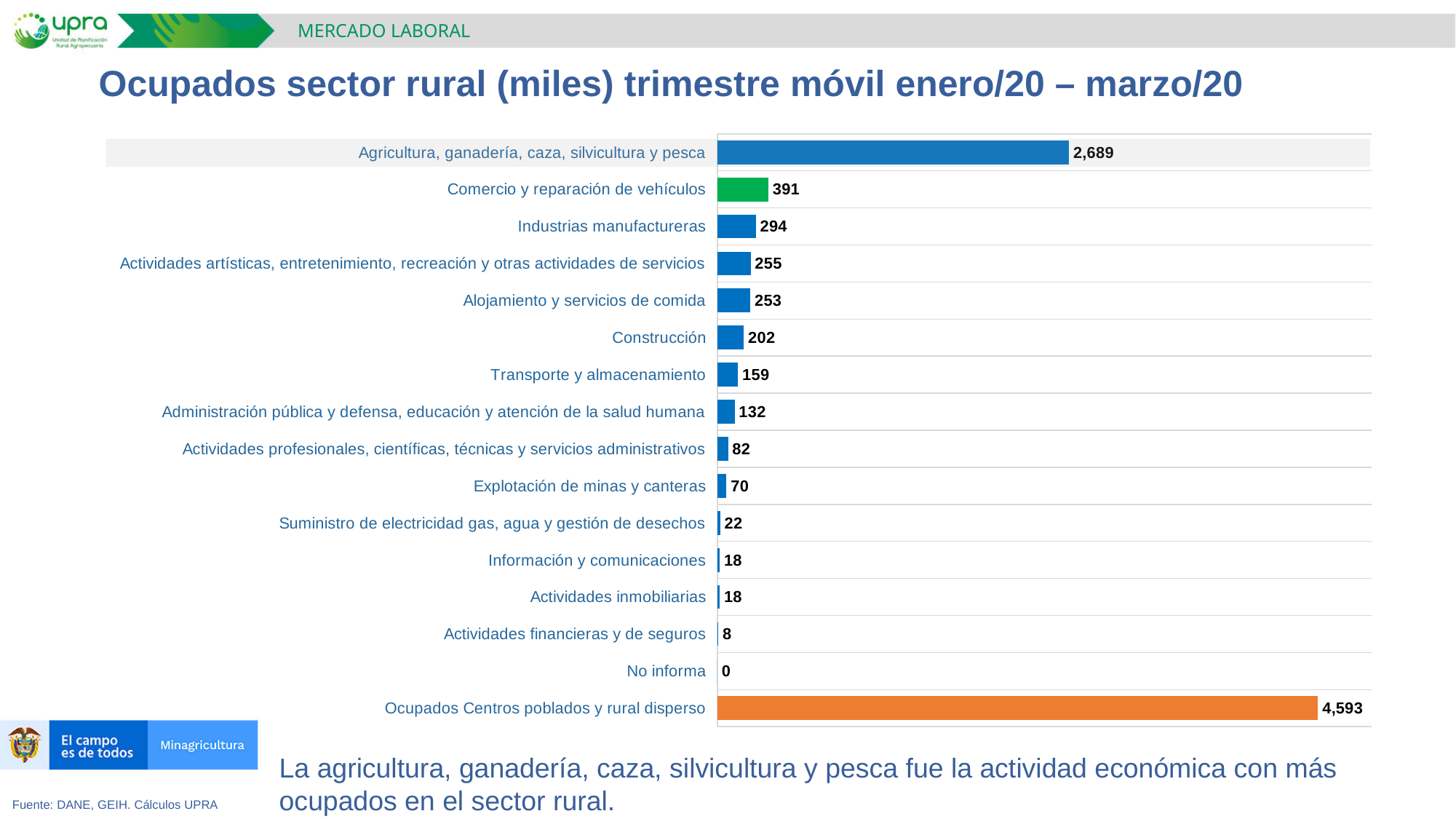
Which is larger, Construcción or Transporte y almacenamiento? Construcción What is the value for Ocupados Centros poblados y rural disperso? 4,593 What is the value for Comercio y reparación de vehículos? 391 Which category has the longest bar in the chart? Ocupados Centros poblados y rural disperso How many categories are shown in the chart? 16 What is the difference between Agricultura, ganadería, caza, silvicultura y pesca and Comercio y reparación de vehículos? 2,298 Which category has the lowest value? No informa What is the value for Explotación de minas y canteras? 70 What is the difference between Industrias manufactureras and Actividades artísticas, entretenimiento, recreación y otras actividades de servicios? 39 What is the value for Agricultura, ganadería, caza, silvicultura y pesca? 2,689 What type of chart is shown on the slide? Bar chart What colour is the bar for Comercio y reparación de vehículos? Green